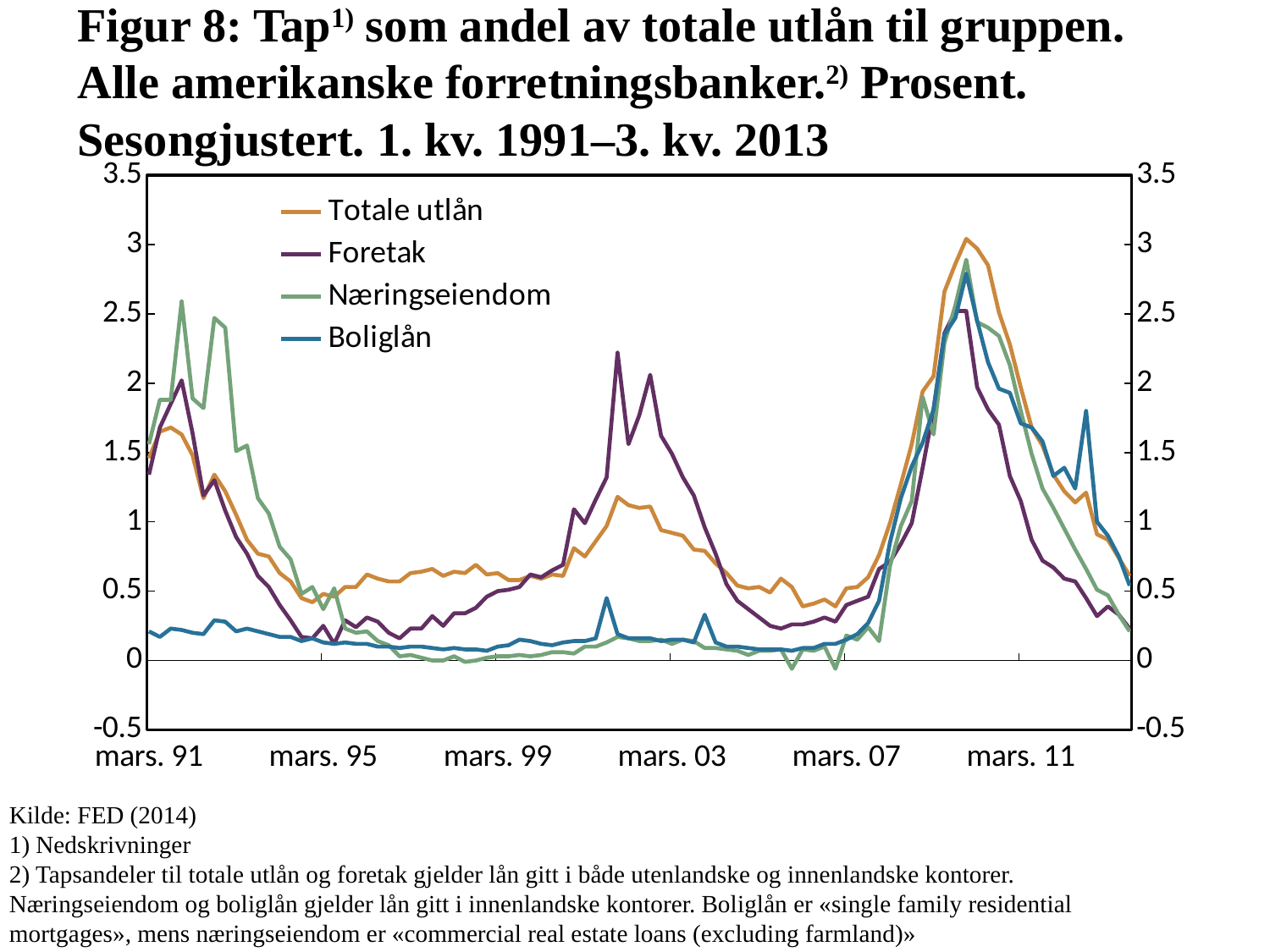
Does the Boliglån series rise or fall between mars. 07 and its peak around 2009–2010? rise Is the value of Boliglån around mars. 99 greater or less than 0.5? less Is the peak value of Næringseiendom in 1991 greater or less than 2? greater Does the Totale utlån series rise or fall from mars. 11 to the end of the chart? fall What is the source cited below the chart? FED (2014) Which series reaches the highest value on the chart? Totale utlån How many series does the legend list? 4 Is the peak value of Totale utlån around 2009–2010 greater or less than 2.5? greater What kind of chart is shown on the slide? line chart Around 2002, which series is higher: Foretak or Boliglån? Foretak Which series are listed in the legend? Totale utlån, Foretak, Næringseiendom, Boliglån